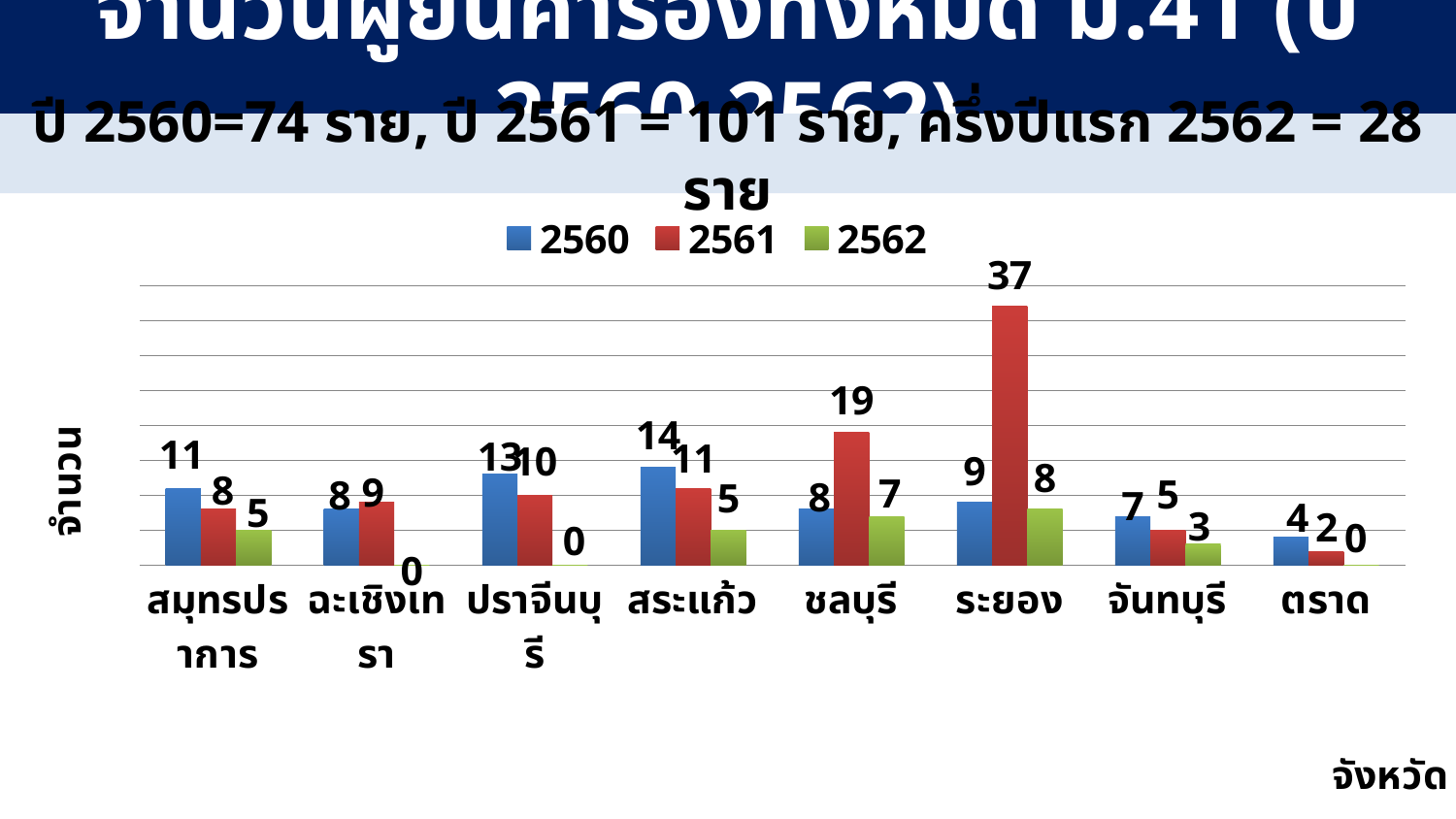
How many series does the legend list? 3 How many provinces (categories) are shown on the x axis? 8 What is the value for สระแก้ว in the 2560 series? 14 Which series is shown in green in the legend? 2562 Which is larger for ปราจีนบุรี: the 2560 value or the 2561 value? 2560 Which province has the lowest value in the 2560 series? ตราด What is the total of the three series values for จันทบุรี? 15 Which province has the highest value in the 2561 series? ระยอง What is the value for ระยอง in the 2561 series? 37 What is the difference between the 2561 and 2560 values for ระยอง? 28 What is the value for ชลบุรี in the 2562 series? 7 What type of chart is shown on the slide? bar chart